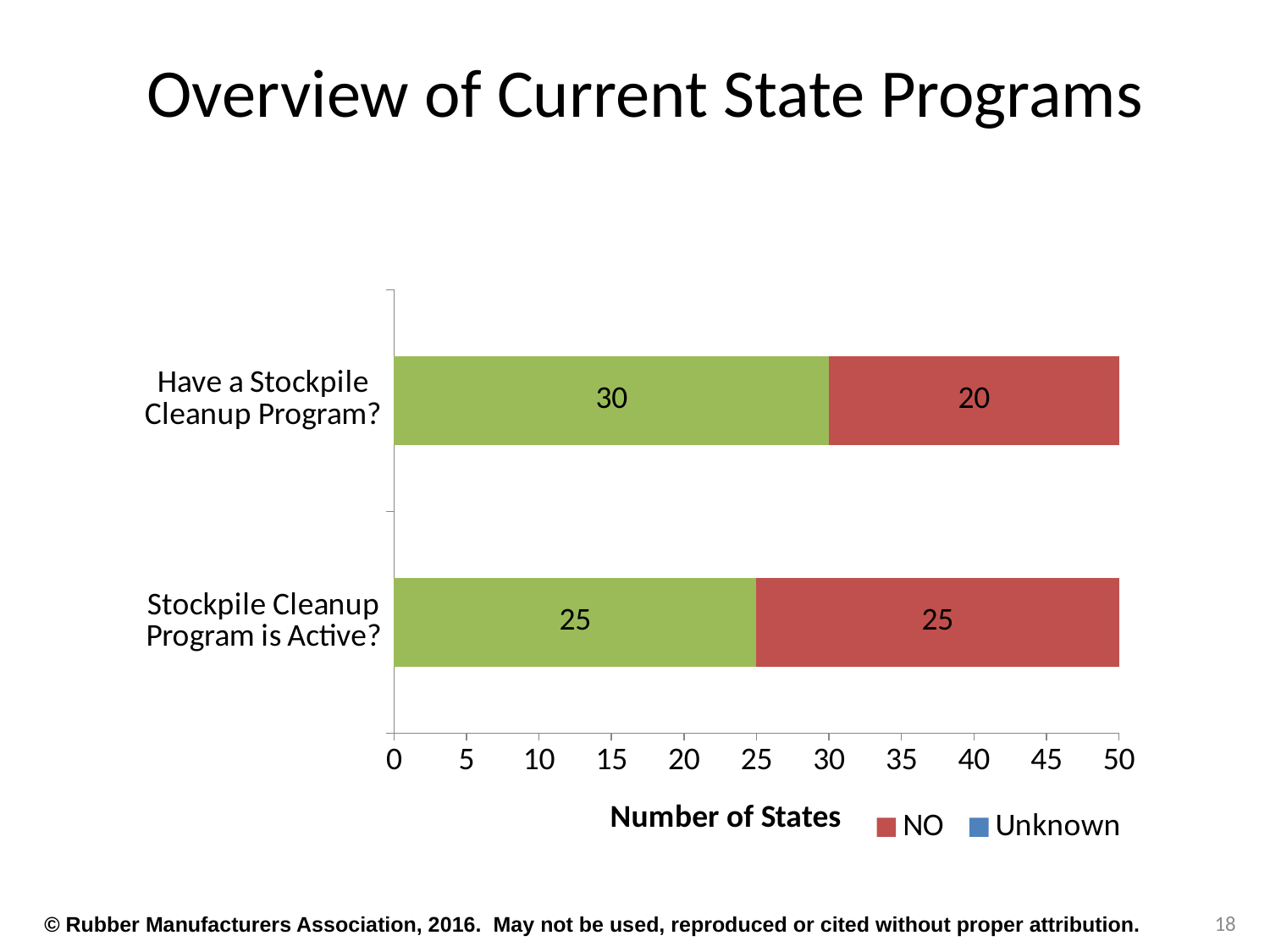
How many categories are shown on the chart? 2 What value is printed on the green segment of the "Stockpile Cleanup Program is Active?" bar? 25 For "Have a Stockpile Cleanup Program?", how much larger is the green segment than the NO segment? 10 Which category has the larger NO value: "Have a Stockpile Cleanup Program?" or "Stockpile Cleanup Program is Active?"? Stockpile Cleanup Program is Active? What is the title of the horizontal axis? Number of States What kind of chart is shown on the slide? Stacked bar chart What is the NO value for "Have a Stockpile Cleanup Program?"? 20 What is the total of the stacked bar for "Have a Stockpile Cleanup Program?"? 50 What is the total of the stacked bar for "Stockpile Cleanup Program is Active?"? 50 Is the green segment for "Have a Stockpile Cleanup Program?" greater or less than 25? greater What is the NO value for "Stockpile Cleanup Program is Active?"? 25 What value is printed on the green segment of the "Have a Stockpile Cleanup Program?" bar? 30